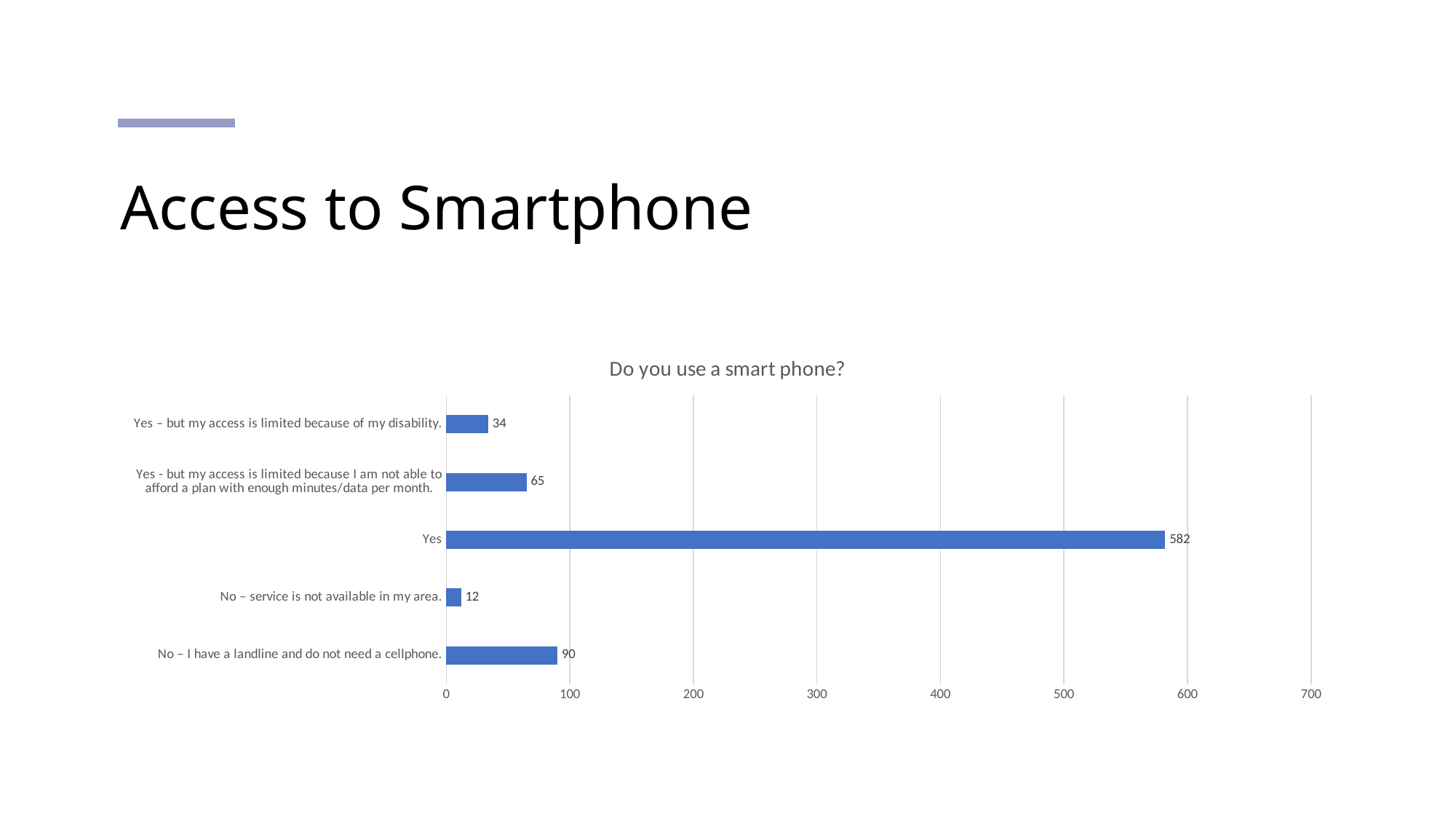
How many categories are shown in the chart? 5 Which category has the highest value? Yes What is the value for "No – service is not available in my area."? 12 What is the value for "Yes"? 582 Which category has the lowest value? No – service is not available in my area. Which is larger: the value for "Yes - but my access is limited because I am not able to afford a plan with enough minutes/data per month." or the value for "Yes – but my access is limited because of my disability."? Yes - but my access is limited because I am not able to afford a plan with enough minutes/data per month. What is the title of the chart? Do you use a smart phone? What is the value for "Yes – but my access is limited because of my disability."? 34 What is the difference between the value for "Yes" and the value for "No – I have a landline and do not need a cellphone."? 492 Is the value for "Yes" greater or less than 500? greater What kind of chart is shown on the slide? bar chart What is the value for "No – I have a landline and do not need a cellphone."? 90